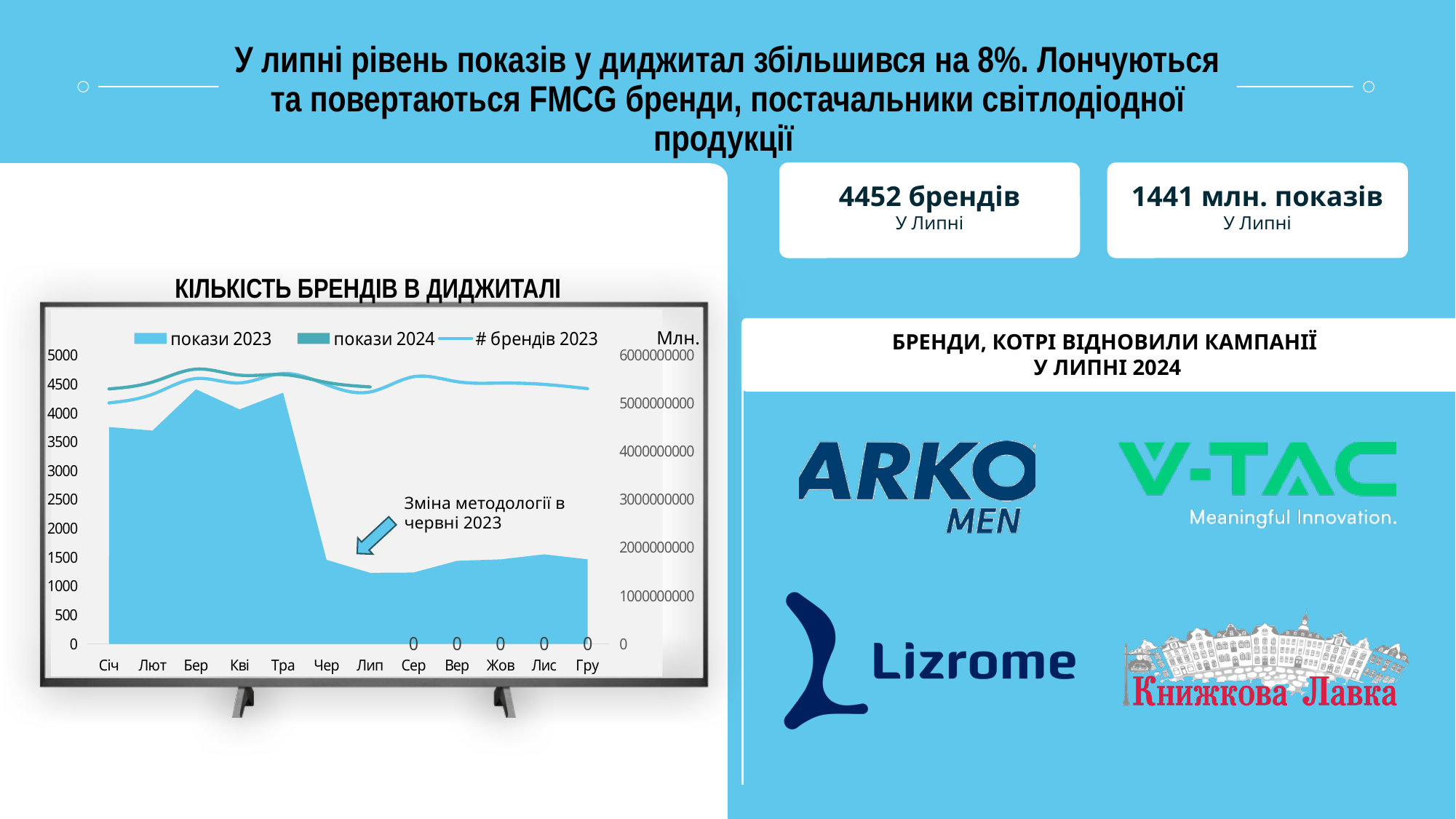
Which month has the larger покази 2023 value, Тра or Чер? Тра What are the three series named in the chart legend? покази 2023, покази 2024, # брендів 2023 Is the # брендів 2023 value for Січ greater or less than 4000 on the left axis? greater What data label is printed for Сер at the bottom of the chart? 0 What is the title of the chart on the slide? КІЛЬКІСТЬ БРЕНДІВ В ДИДЖИТАЛІ Does the покази 2023 area rise or fall between Тра and Чер? Fall Is the покази 2023 value for Лип greater or less than 2000 on the left axis? less How many months are shown along the x axis of the chart? 12 How many series does the chart legend list? 3 What kind of chart is shown on the slide? Area chart with line series Is the покази 2023 value for Бер greater or less than 4000 on the left axis? greater Which month has the larger покази 2023 value, Січ or Лип? Січ